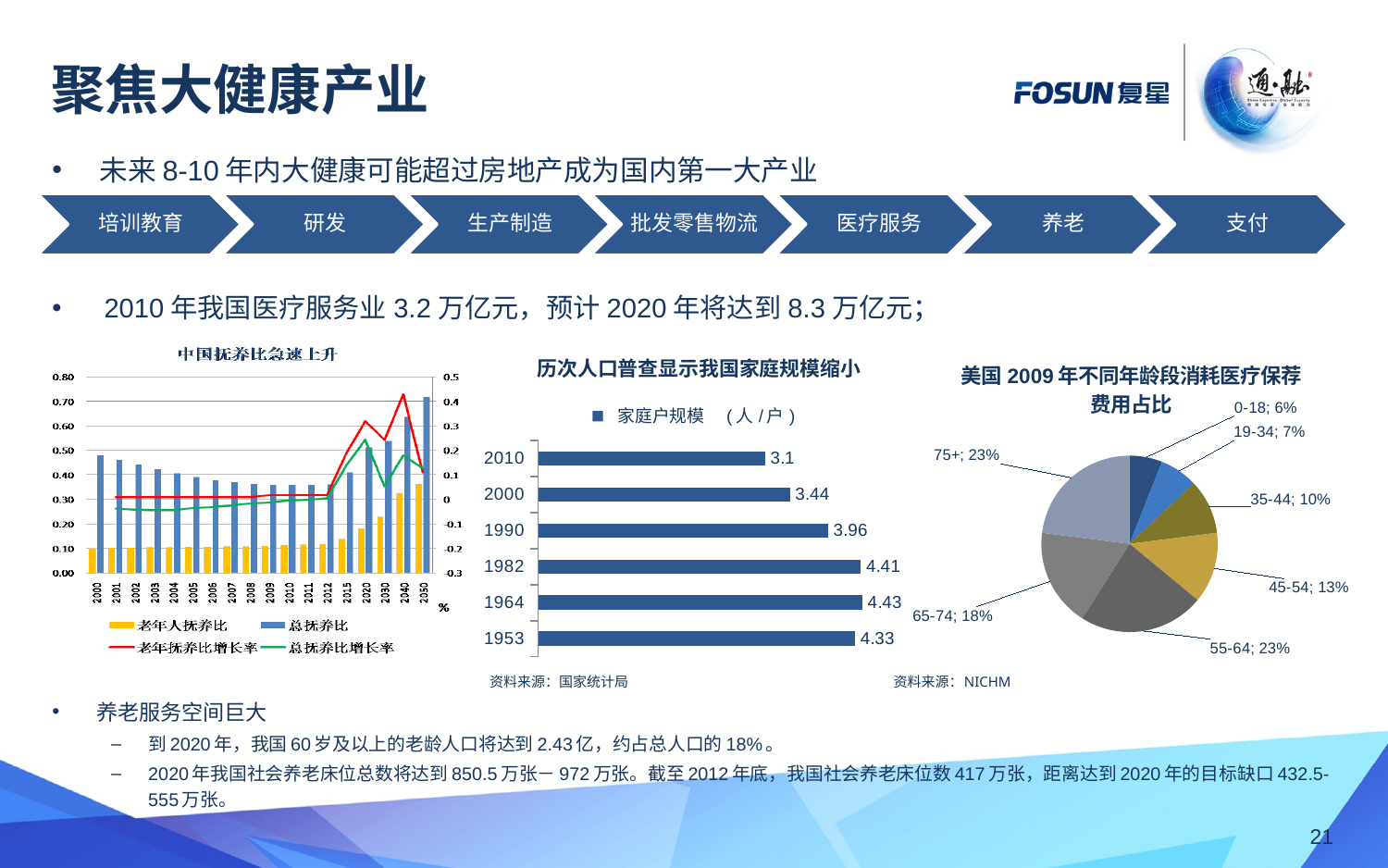
In the pie chart titled 美国2009年不同年龄段消耗医疗保荐费用占比, which is larger, the share for 45-54 or the share for 35-44? 45-54 In the chart titled 中国抚养比急速上升, how many series does the legend list? 4 In the pie chart titled 美国2009年不同年龄段消耗医疗保荐费用占比, how many age groups are shown? 7 In the chart titled 历次人口普查显示我国家庭规模缩小, what is the value for 1982? 4.41 In the pie chart titled 美国2009年不同年龄段消耗医疗保荐费用占比, what share does the 65-74 age group have? 18% In the chart titled 历次人口普查显示我国家庭规模缩小, what is the value for 2010? 3.1 In the pie chart titled 美国2009年不同年龄段消耗医疗保荐费用占比, which age group has the smallest share? 0-18 In the chart titled 历次人口普查显示我国家庭规模缩小, what kind of chart is it? Bar chart In the chart titled 历次人口普查显示我国家庭规模缩小, which year has the highest value? 1964 In the chart titled 历次人口普查显示我国家庭规模缩小, what is the difference between the values for 1990 and 2000? 0.52 In the chart titled 历次人口普查显示我国家庭规模缩小, how many years are shown? 6 In the chart titled 历次人口普查显示我国家庭规模缩小, which year has the lowest value? 2010